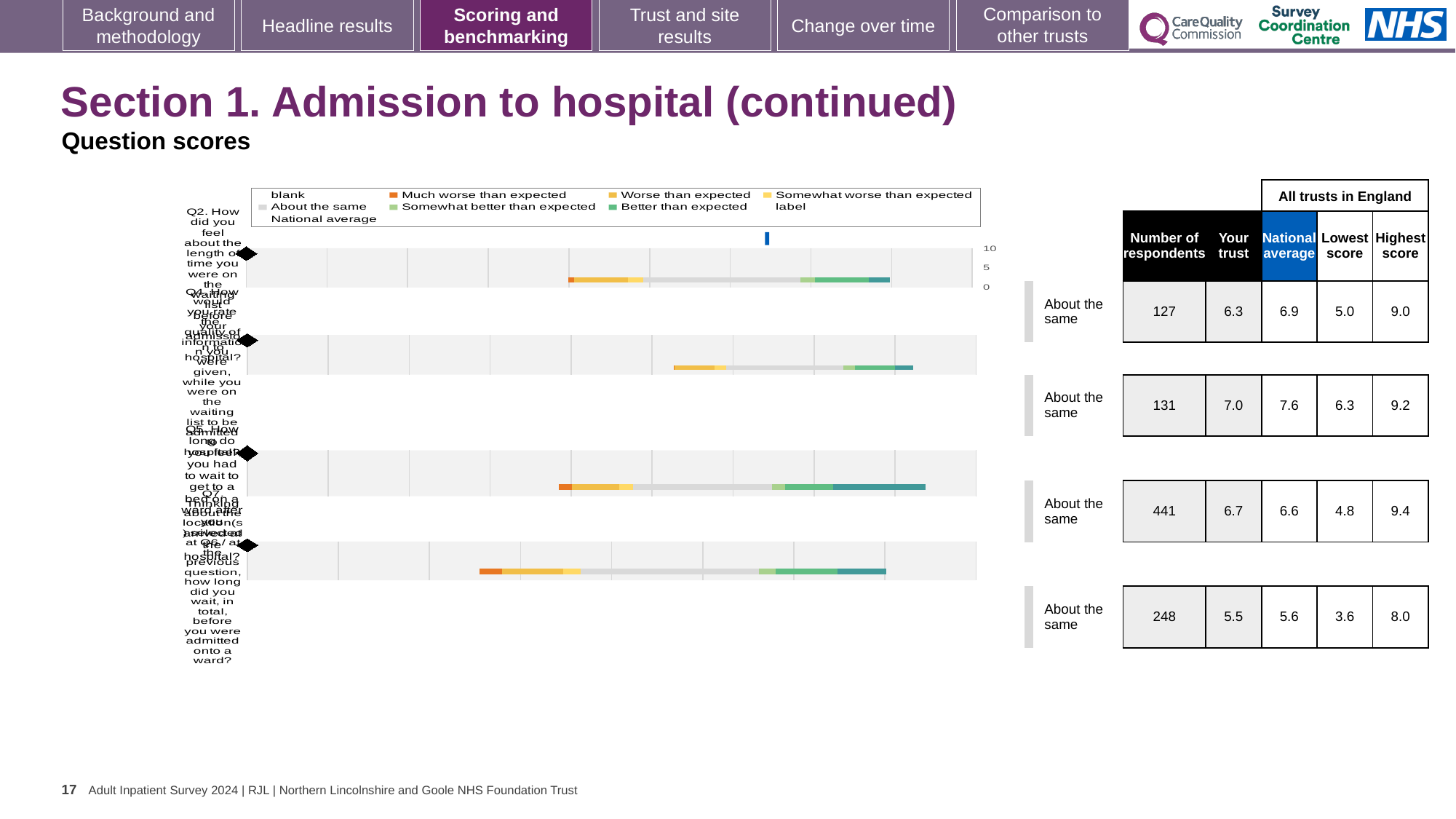
In the table to the right of the chart, what is the national average in the third row? 6.6 How many entries does the chart's legend list? 9 What kind of chart is shown on the slide? bar chart What is the highest tick value shown on the chart's axis? 10 In the table to the right of the chart, which row has the largest number of respondents? the third row (441) In the table to the right of the chart, what is the highest score in the fourth row? 8.0 How many horizontal bars are plotted in the chart? 4 In the table to the right of the chart, what is the 'Your trust' score in the second row? 7.0 In the table to the right of the chart, what is the number of respondents in the first row? 127 Which legend entry is shown in dark orange in the chart? Much worse than expected In the table to the right of the chart, what is the difference between the national average and the 'Your trust' score in the first row? 0.6 In the table to the right of the chart, in the third row, which is larger: the 'Your trust' score or the national average? Your trust